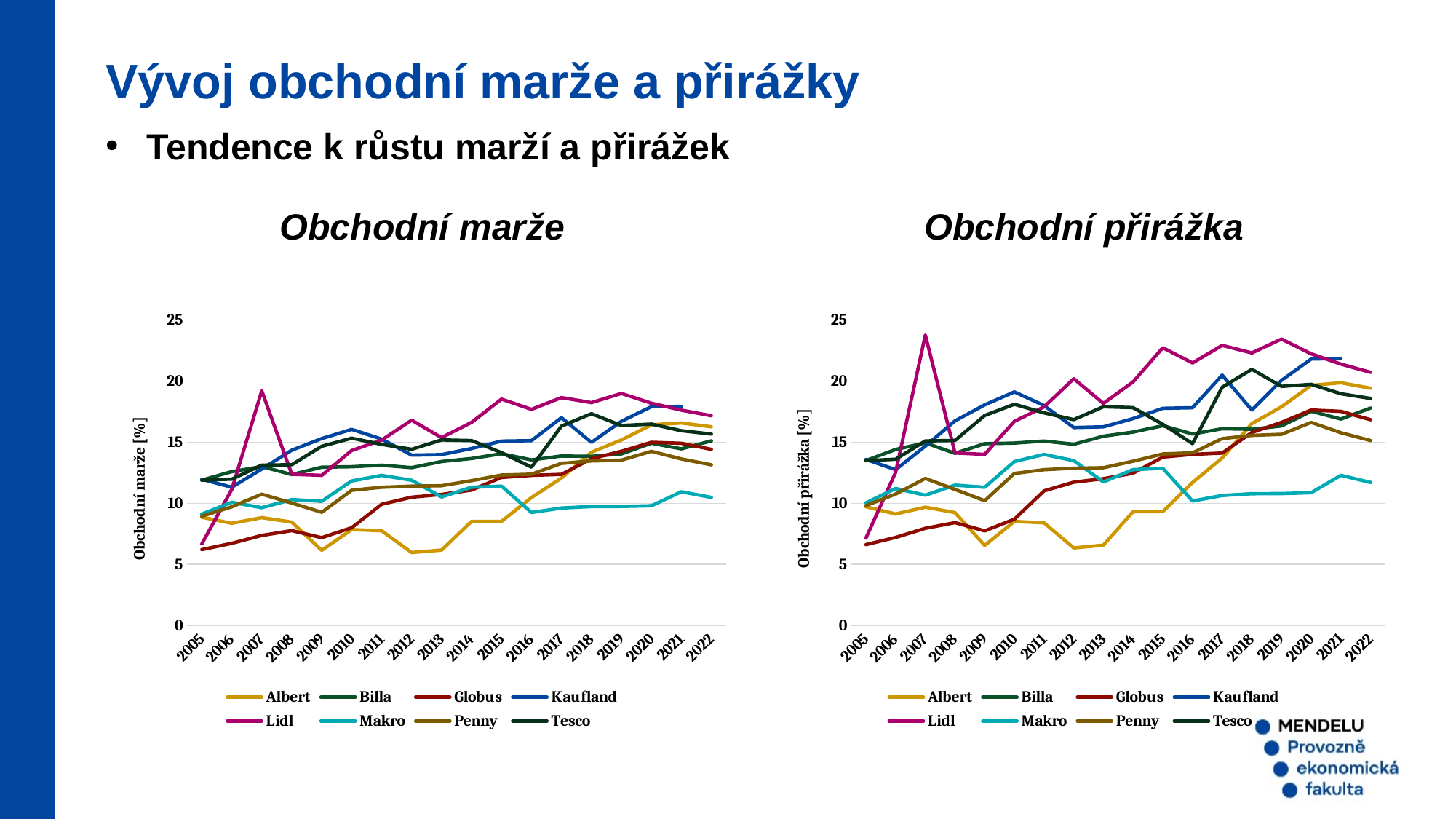
What type of chart is the "Obchodní marže" chart? line chart In the "Obchodní přirážka" chart, is the value for Lidl in 2007 greater or less than 20? greater How many years are shown on the x axis of the "Obchodní marže" chart? 18 In the "Obchodní přirážka" chart, does the Albert series generally rise or fall from 2013 to 2020? rise In the "Obchodní marže" chart, which series has the lowest value in 2022? Makro In the "Obchodní marže" chart, is the value for Albert in 2012 greater or less than 10? less How many series does the legend of the "Obchodní přirážka" chart list? 8 What is the y-axis label of the "Obchodní marže" chart? Obchodní marže [%] In the "Obchodní přirážka" chart, which series has the lowest value in 2022? Makro In the "Obchodní přirážka" chart, which series has the highest value in 2007? Lidl In the "Obchodní marže" chart, is the value for Lidl in 2007 greater or less than 15? greater